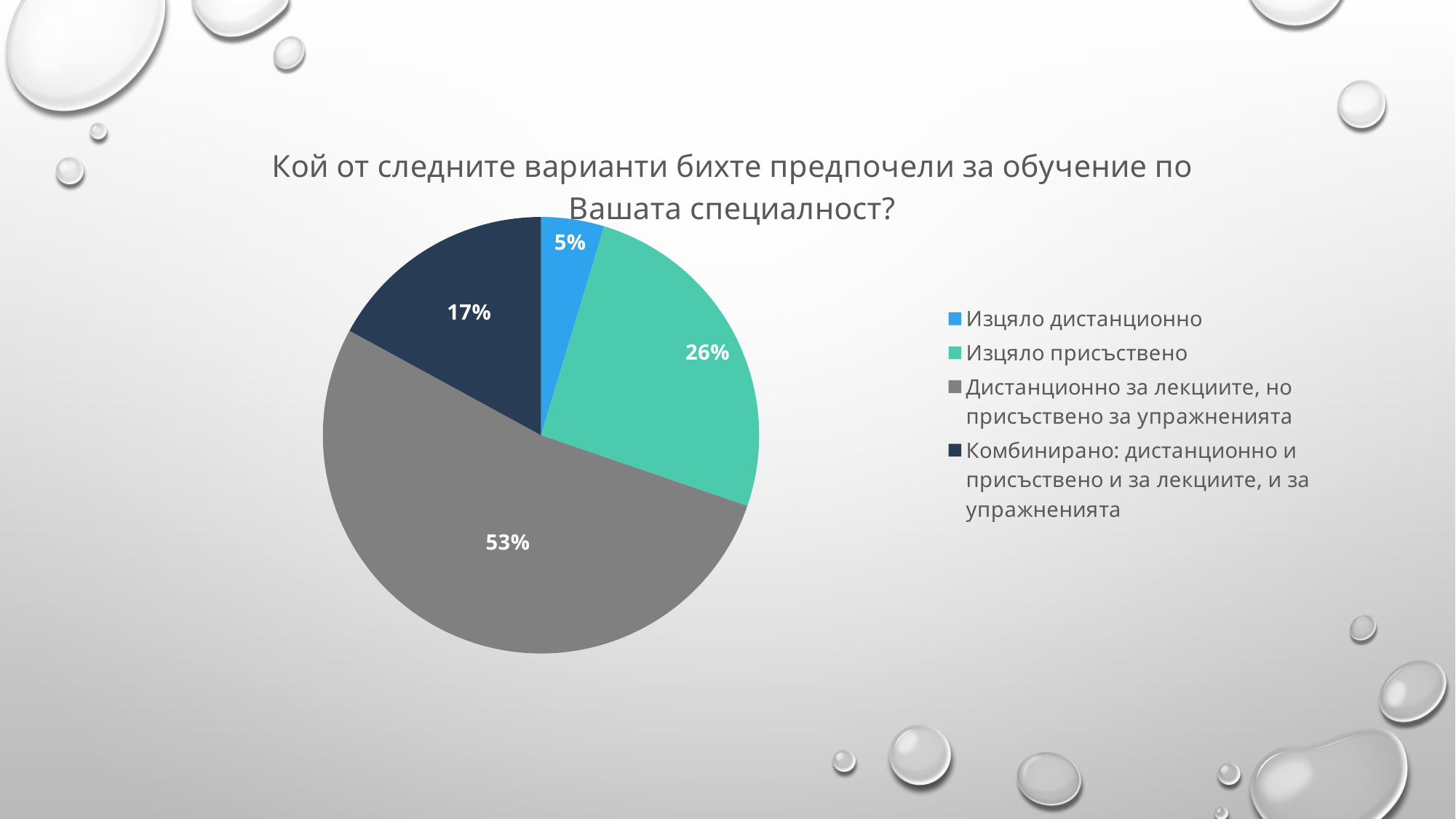
What share of the pie does "Изцяло присъствено" have? 26% How many slices does the pie chart have? 4 What kind of chart is shown on the slide? Pie chart Which option has the smallest share of the pie? Изцяло дистанционно Which is larger: the share for "Изцяло присъствено" or the share for "Изцяло дистанционно"? Изцяло присъствено What is the title of the chart? Кой от следните варианти бихте предпочели за обучение по Вашата специалност? What share of the pie does "Комбинирано: дистанционно и присъствено и за лекциите, и за упражненията" have? 17% What colour is the slice for "Изцяло присъствено"? Green (teal) What is the difference in percentage points between "Изцяло присъствено" and "Комбинирано: дистанционно и присъствено и за лекциите, и за упражненията"? 9 percentage points What share of the pie does "Изцяло дистанционно" have? 5% Which option has the largest share of the pie? Дистанционно за лекциите, но присъствено за упражненията